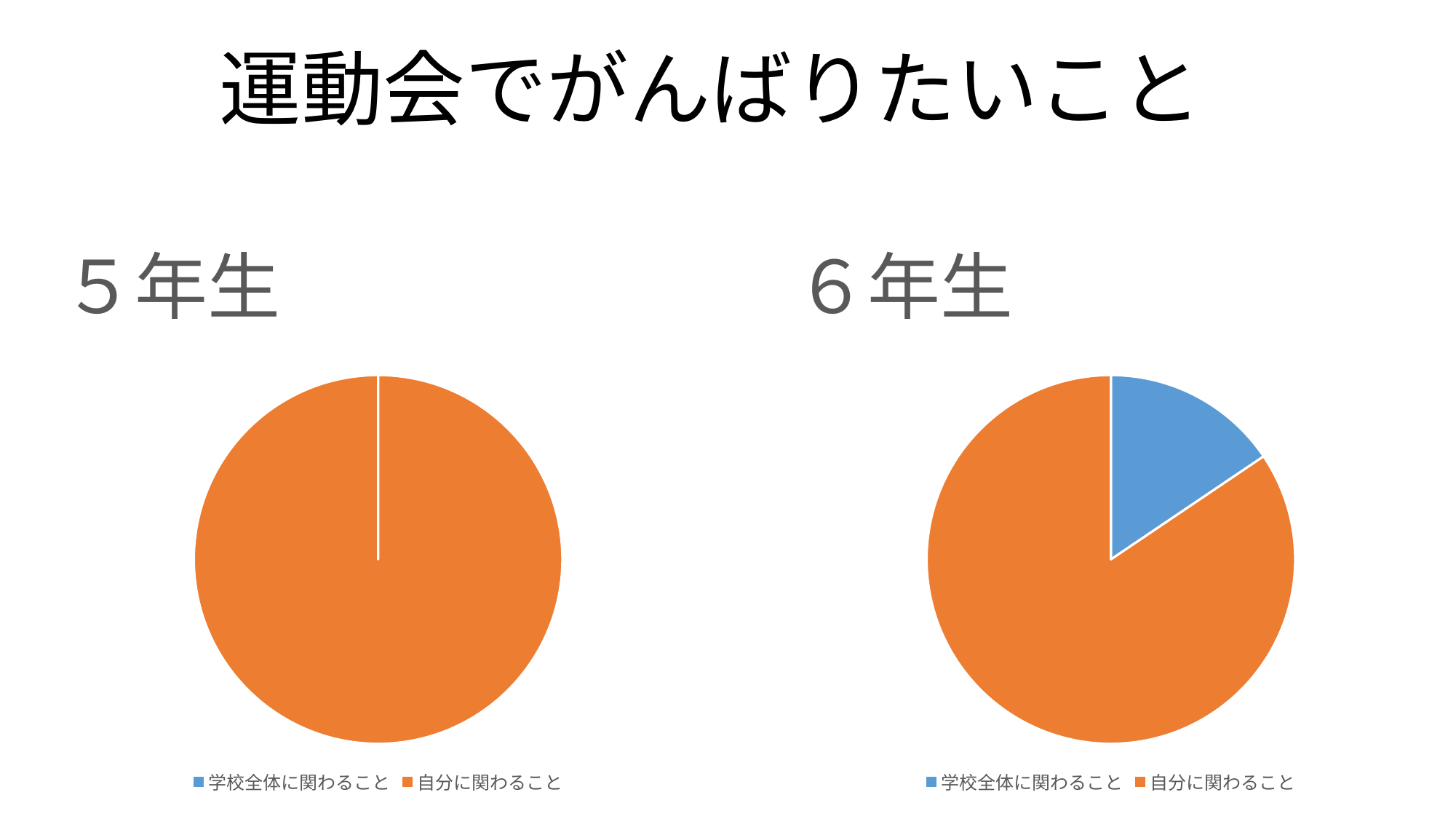
What kind of chart is the 6年生 chart? pie chart In the 6年生 chart, which slice is larger: 学校全体に関わること or 自分に関わること? 自分に関わること How many charts are shown on the slide? 2 How many entries does the legend of the 6年生 chart list? 2 In the 5年生 chart, which category takes up the whole pie? 自分に関わること What kind of chart is the 5年生 chart? pie chart In the 6年生 chart, which category has the largest slice? 自分に関わること In the 6年生 chart, which category has the smallest slice? 学校全体に関わること How many entries does the legend of the 5年生 chart list? 2 What is the title of the slide? 運動会でがんばりたいこと What colour represents 学校全体に関わること in the legend? blue